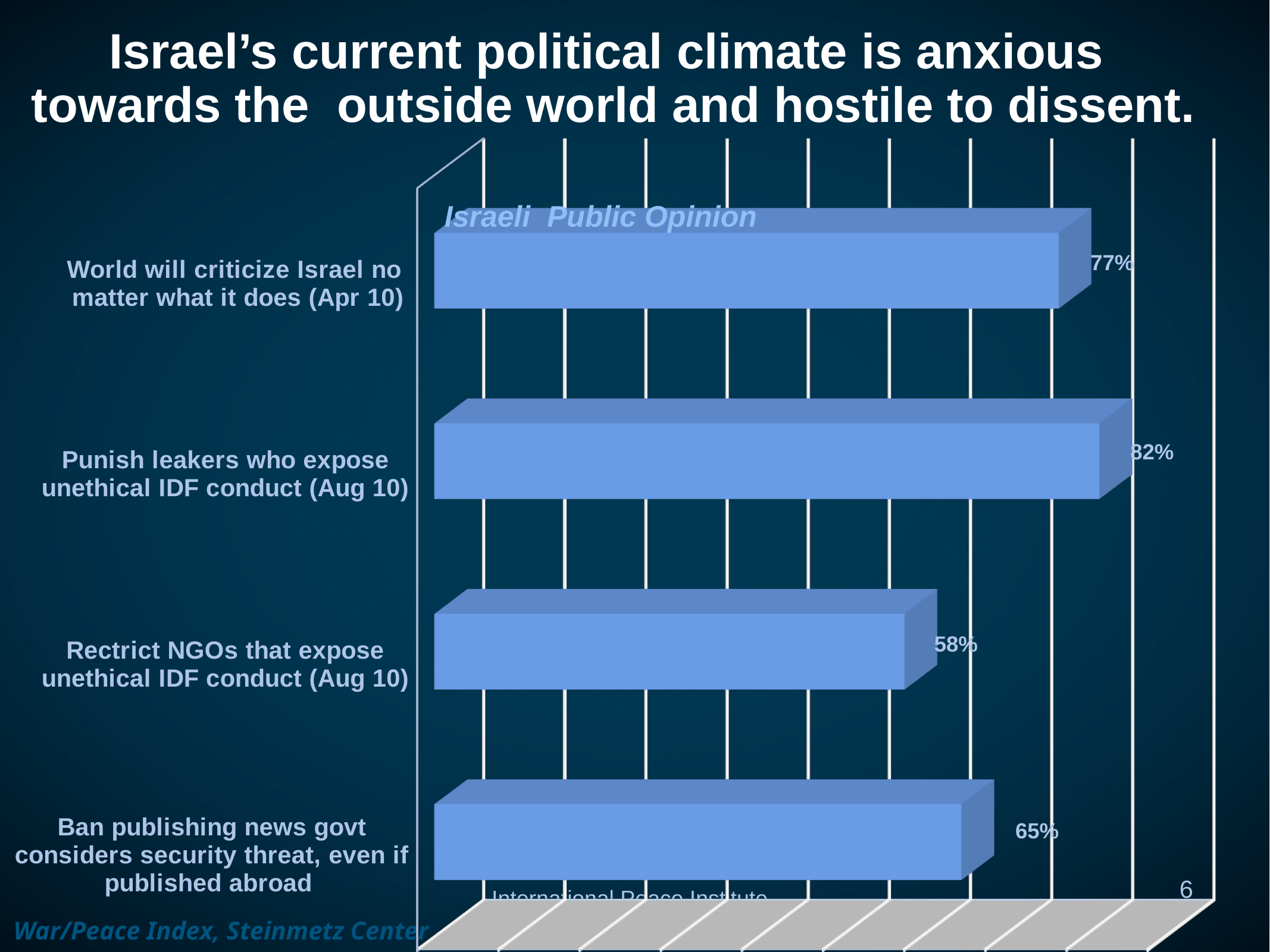
What percentage of Israelis believe the world will criticize Israel no matter what it does (Apr 10)? 77% What kind of chart is shown on the slide? Bar chart What is the difference between the value for 'World will criticize Israel no matter what it does' and the value for banning publishing news the government considers a security threat? 12% Which category has the lowest value? Rectrict NGOs that expose unethical IDF conduct (Aug 10) Which is larger: the value for 'World will criticize Israel no matter what it does' or the value for 'Punish leakers who expose unethical IDF conduct'? Punish leakers who expose unethical IDF conduct What is the difference between the value for punishing leakers and the value for restricting NGOs? 24% Which category has the highest value? Punish leakers who expose unethical IDF conduct (Aug 10) What is the value for 'Punish leakers who expose unethical IDF conduct (Aug 10)'? 82% What is the title of the chart? Israeli Public Opinion What percentage supports banning publishing news the government considers a security threat, even if published abroad? 65% What is the value for 'Rectrict NGOs that expose unethical IDF conduct (Aug 10)'? 58% How many categories are shown in the chart? 4